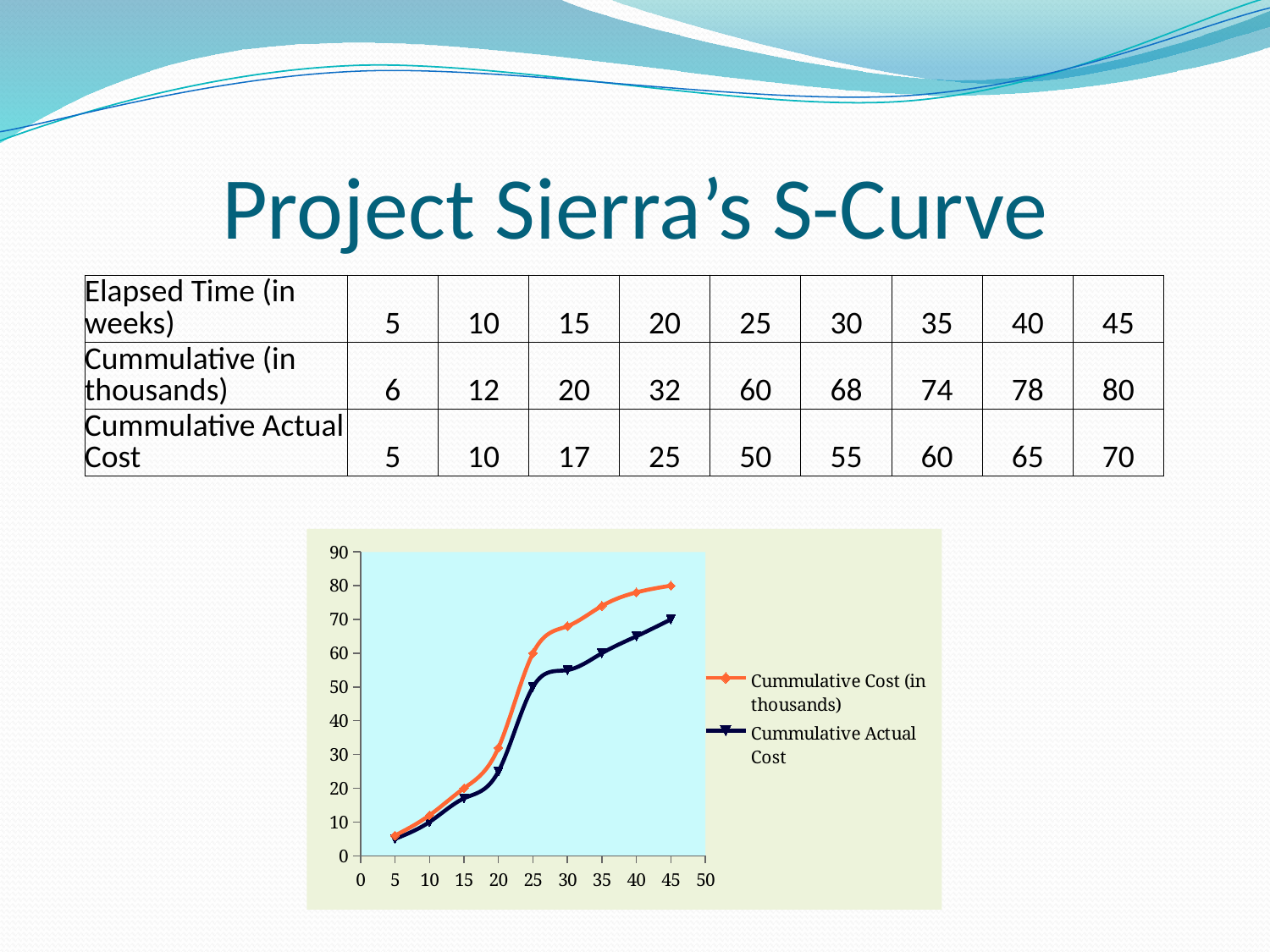
How many data points are plotted for the Cummulative Cost (in thousands) series? 9 What is the Cummulative Cost (in thousands) at 25 weeks? 60 What is the title of the slide containing the chart? Project Sierra's S-Curve At 45 weeks, what is the difference between the Cummulative Cost (in thousands) and the Cummulative Actual Cost? 10 At 20 weeks, which series has the higher value: Cummulative Cost (in thousands) or Cummulative Actual Cost? Cummulative Cost (in thousands) What kind of chart is shown on the slide? line chart What is the Cummulative Actual Cost at 45 weeks? 70 Is the Cummulative Actual Cost at 30 weeks greater or less than 60? less How many series does the chart's legend list? 2 Do the values of the Cummulative Actual Cost series rise or fall as elapsed time increases? rise At which elapsed time (in weeks) does the Cummulative Cost (in thousands) reach its highest value? 45 Is the Cummulative Cost (in thousands) at 35 weeks greater or less than 70? greater